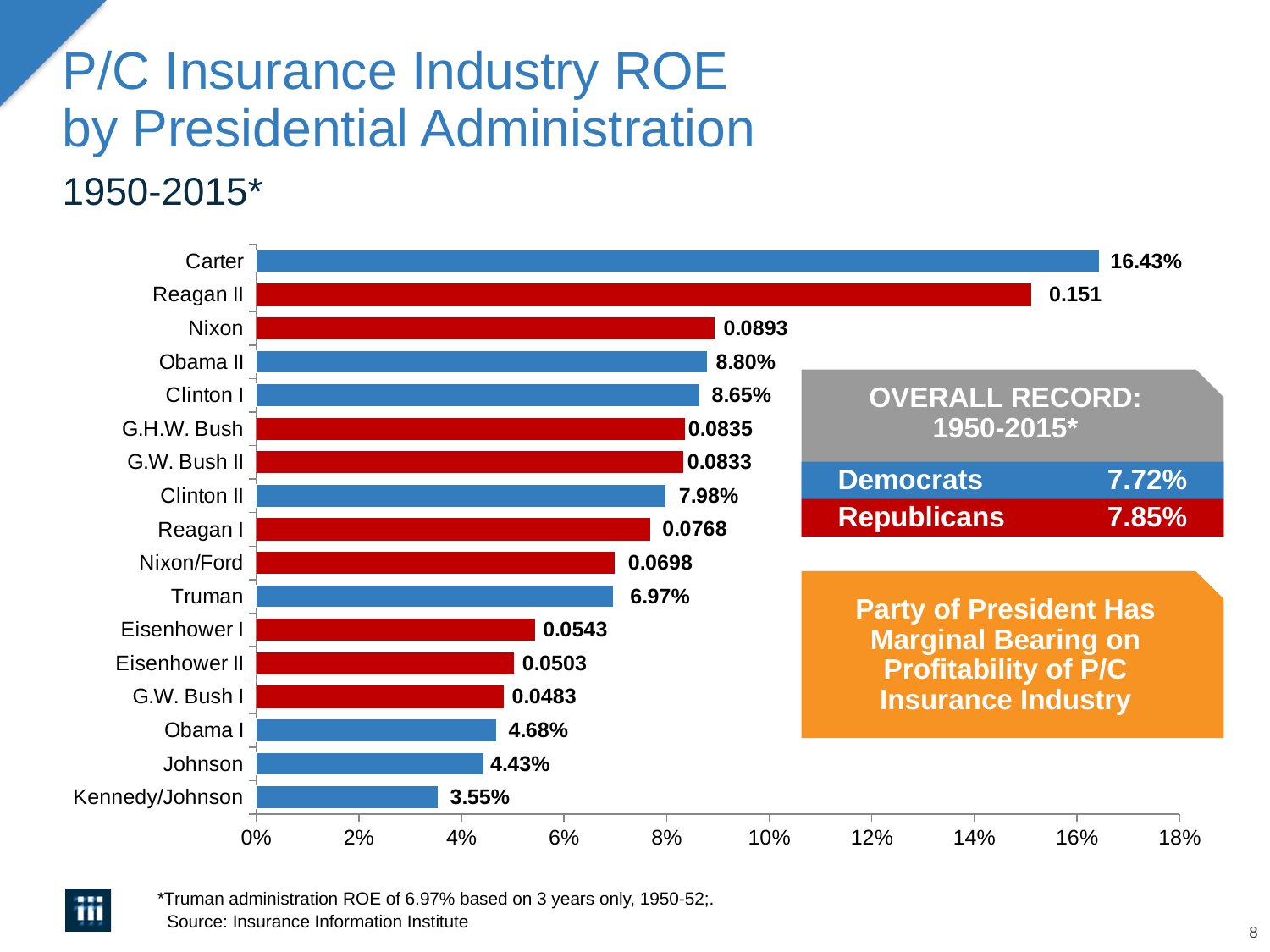
How many presidential administrations are plotted in the chart? 17 What is the ROE value shown for Truman? 6.97% What type of chart is shown on the slide? Bar chart According to the overall record box, what is the ROE for Republicans? 7.85% What is the ROE value shown for Carter? 16.43% Which administration has the highest ROE in the chart? Carter What is the value labeled on the bar for Reagan II? 0.151 Which has a higher ROE, Obama I or Johnson? Obama I Is the value for Reagan II greater or less than 14%? greater What is the value labeled on the bar for Nixon/Ford? 0.0698 What is the difference between the ROE for Carter and the ROE for Obama II? 7.63 percentage points Which administration has the lowest ROE in the chart? Kennedy/Johnson